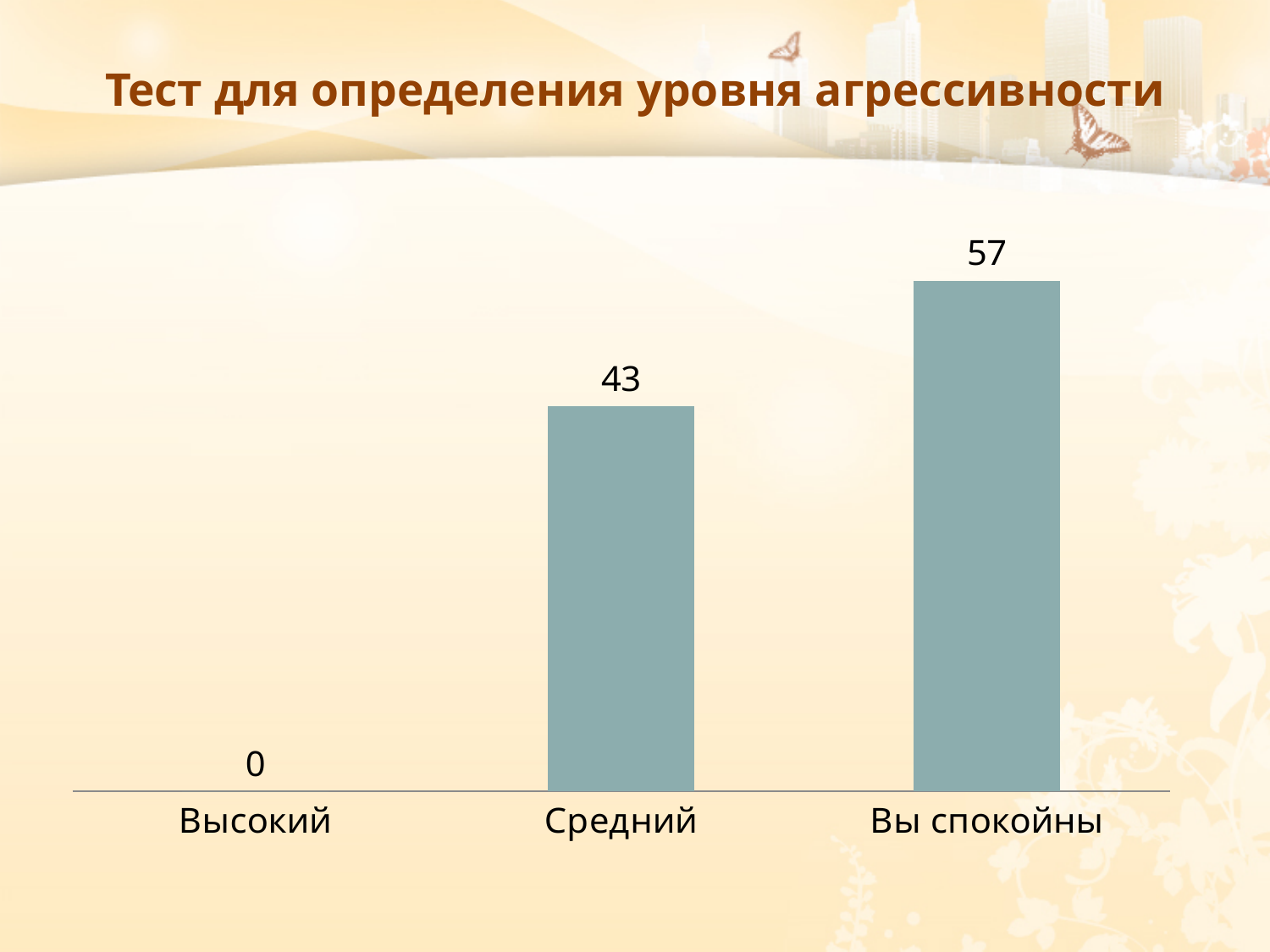
How many categories are shown on the x axis? 3 What is the value for Средний? 43 What is the total of the three values shown? 100 What kind of chart is shown on the slide? bar chart Do the values rise or fall from left to right along the x axis? rise Which category has the lowest value? Высокий What is the value for Высокий? 0 What is the title of the slide? Тест для определения уровня агрессивности Which is larger, the value for Средний or the value for Вы спокойны? Вы спокойны What is the value for Вы спокойны? 57 What is the difference between the values for Вы спокойны and Средний? 14 Which category has the highest value? Вы спокойны